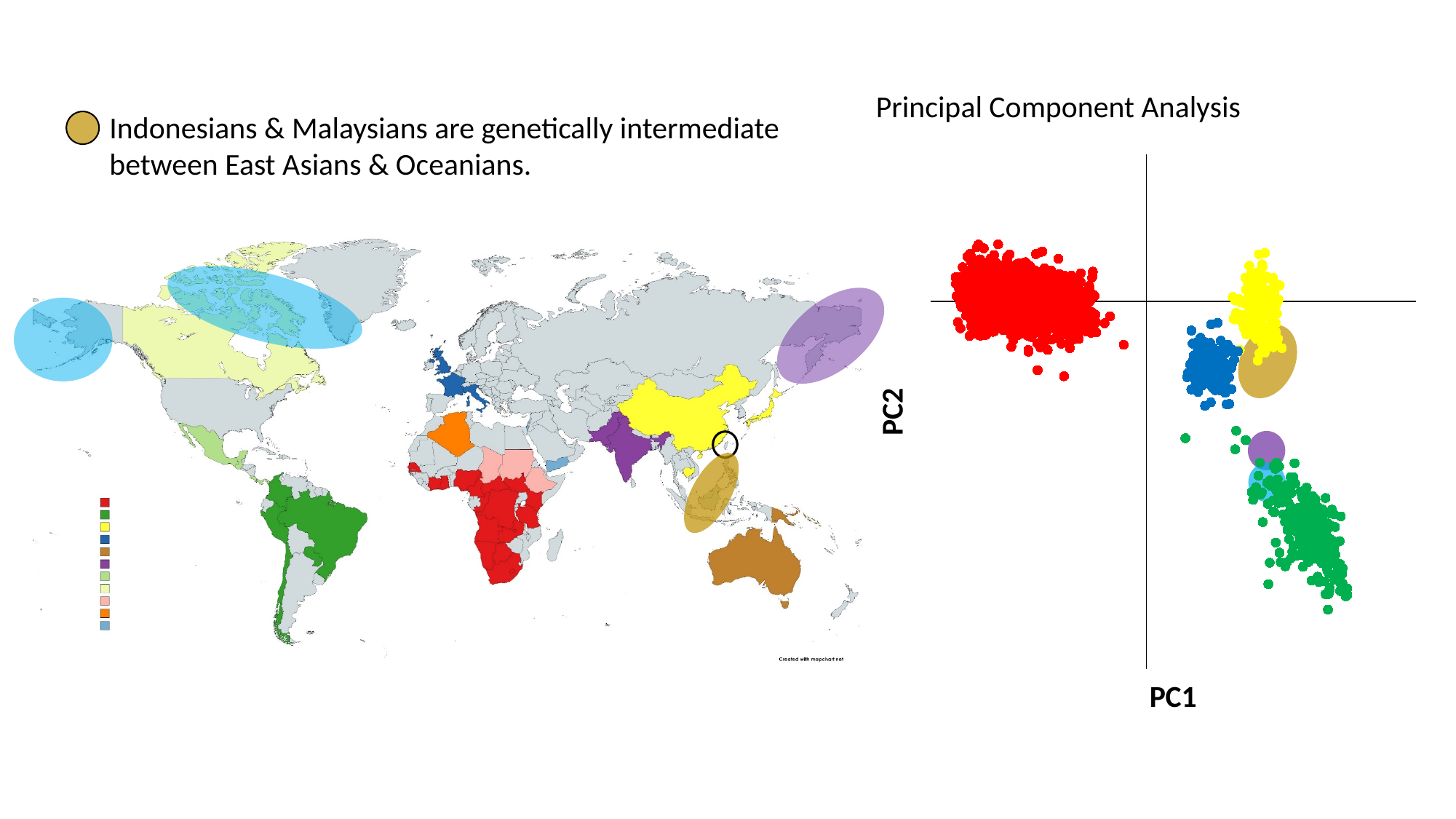
What is the title of the chart on the right side of the slide? Principal Component Analysis In the Principal Component Analysis chart, which cluster has the higher PC2 values, the yellow cluster or the green cluster? yellow In the Principal Component Analysis chart, which coloured cluster extends lowest along PC2? green What kind of chart is the Principal Component Analysis chart? scatter plot In the Principal Component Analysis chart, what are the labels of the horizontal and vertical axes? PC1 and PC2 In the Principal Component Analysis chart, which coloured cluster lies furthest to the left along PC1? red In the Principal Component Analysis chart, is the red cluster on the positive or negative side of the PC1 axis? negative In the Principal Component Analysis chart, which cluster has the higher PC1 values, the red cluster or the green cluster? green